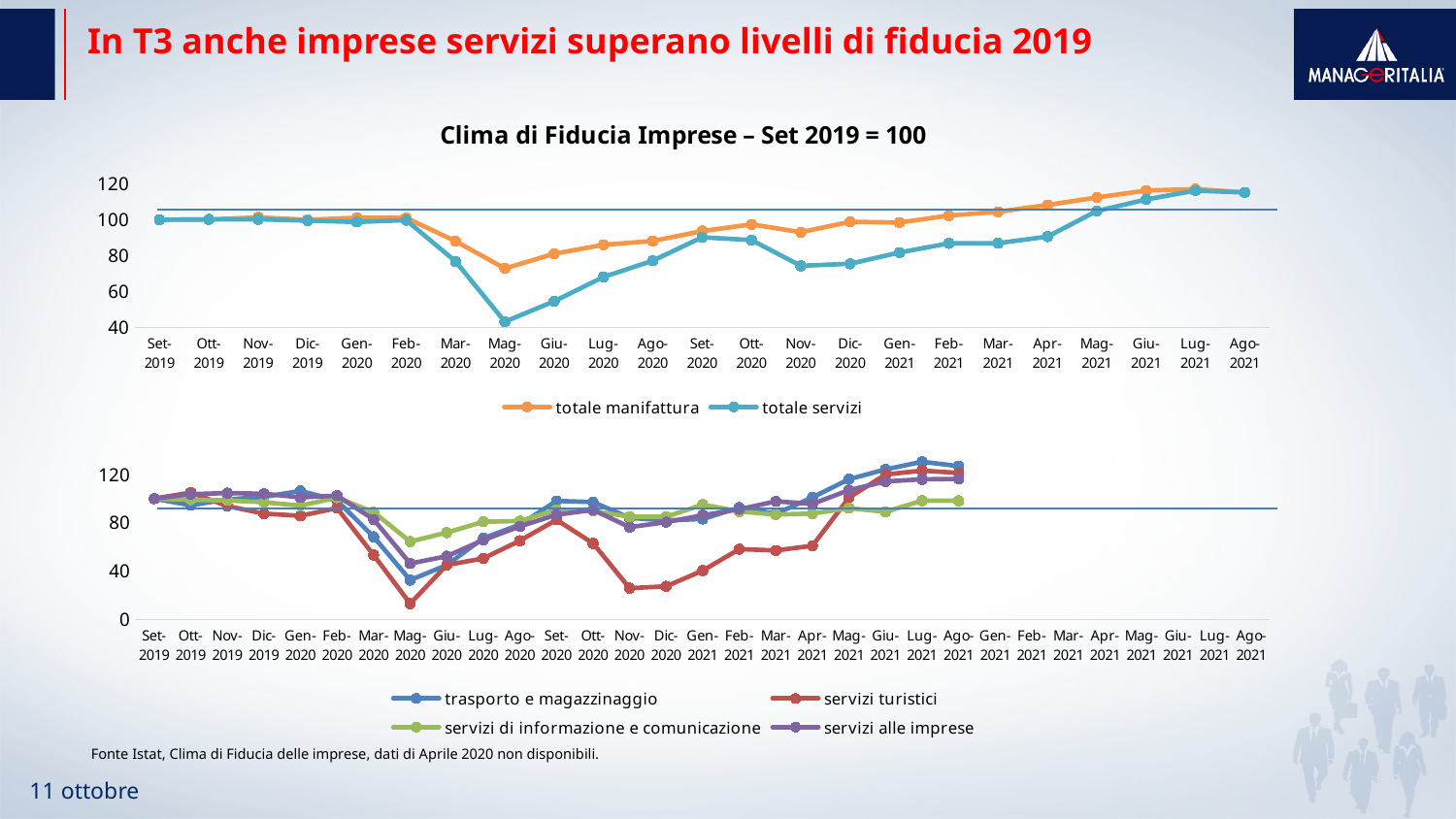
How many series does the legend of the bottom chart list? 4 In the top chart, is the value of 'totale manifattura' at Mag-2020 greater or less than 60? greater In the top chart, which series has the higher value at Nov-2020, 'totale manifattura' or 'totale servizi'? totale manifattura How many series does the legend of the top chart list? 2 In the top chart, at which month does 'totale servizi' reach its lowest value? Mag-2020 In the bottom chart, is the value of 'trasporto e magazzinaggio' at Lug-2021 greater or less than 120? greater In the top chart, is the value of 'totale servizi' at Nov-2020 greater or less than 80? less What type of chart is the top chart titled 'Clima di Fiducia Imprese – Set 2019 = 100'? Line chart In the top chart, what is the title shown above the plot? Clima di Fiducia Imprese – Set 2019 = 100 In the bottom chart, which series has the lowest value at Mag-2020? servizi turistici